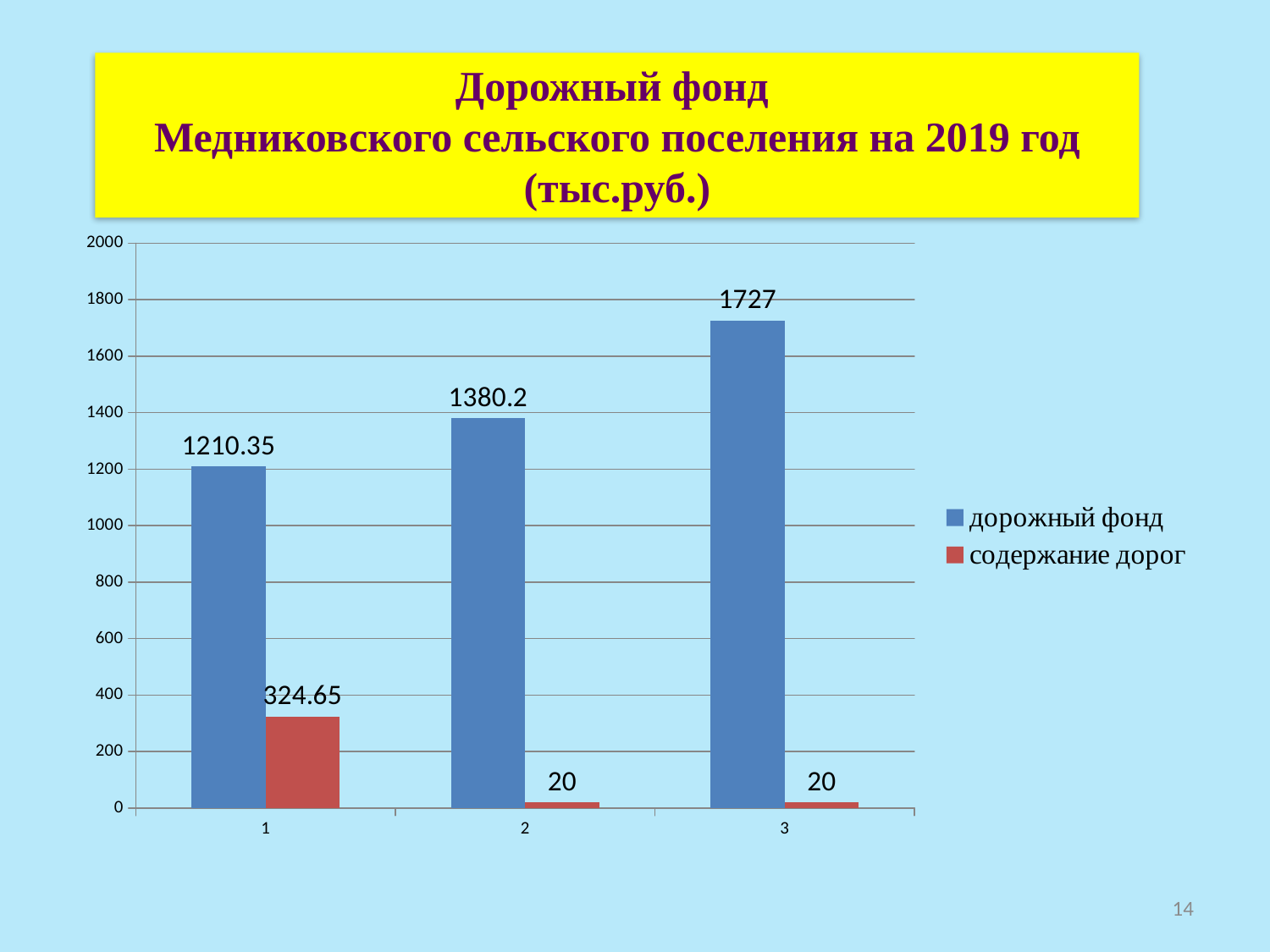
What is the value of "содержание дорог" for category 1? 324.65 How many series does the legend list? 2 What is the value of "дорожный фонд" for category 3? 1727 What is the value of "дорожный фонд" for category 1? 1210.35 How many categories are shown on the x axis? 3 What kind of chart is shown on the slide? bar chart What is the difference between the "дорожный фонд" values for category 3 and category 2? 346.8 Do the "дорожный фонд" values rise or fall from category 1 to category 3? rise Which is larger: "дорожный фонд" for category 2 or "дорожный фонд" for category 1? category 2 Which category has the highest value for "дорожный фонд"? 3 Which category has the lowest value for "дорожный фонд"? 1 What is the value of "содержание дорог" for category 2? 20